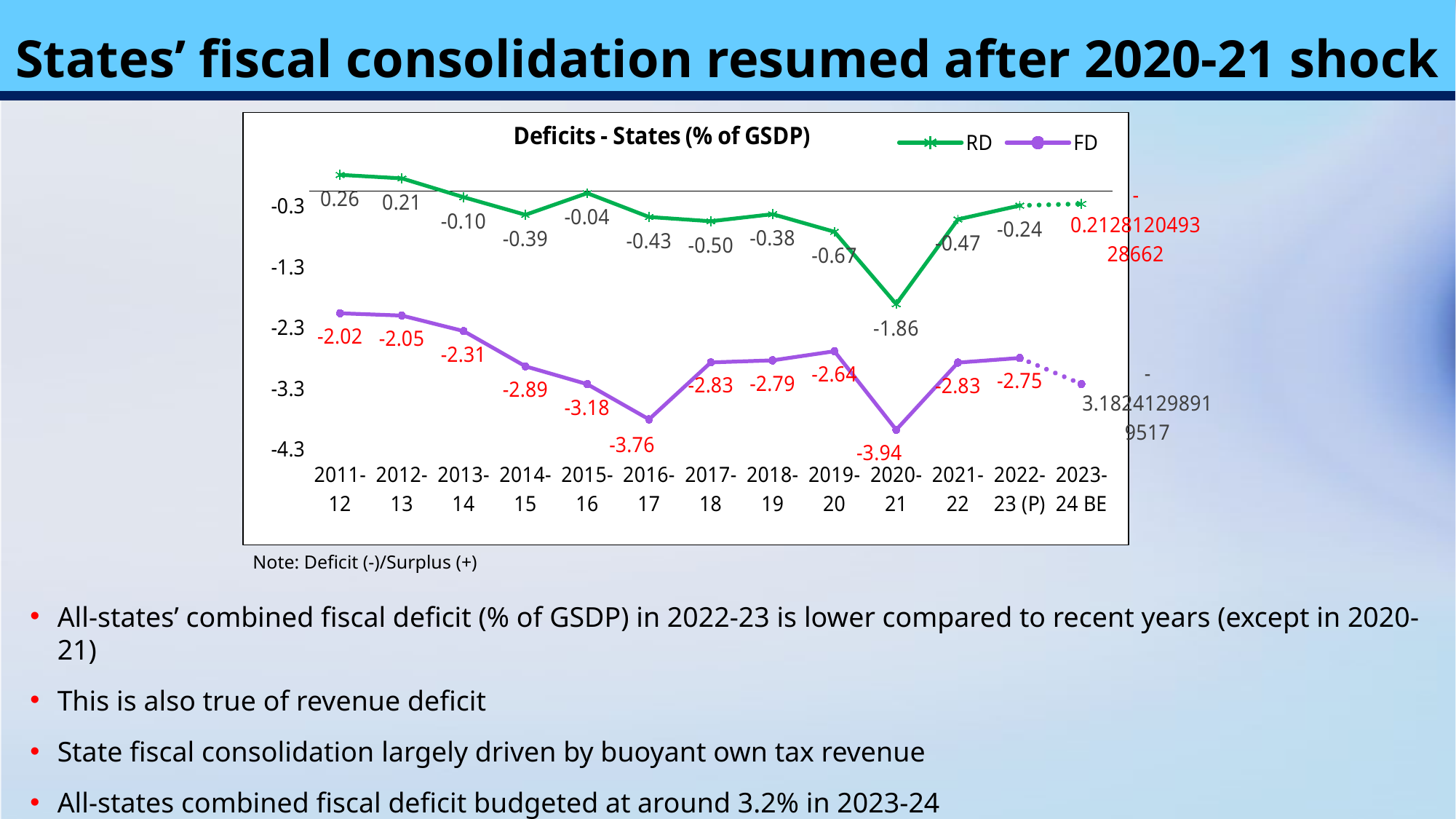
What kind of chart is shown on the slide? line chart How many years are shown on the x axis of the chart? 13 How many series does the legend of the chart list? 2 What is the FD value for 2022-23 (P)? -2.75 Which year has the larger RD value, 2014-15 or 2015-16? 2015-16 Does the FD series rise or fall from 2011-12 to 2016-17? fall What is the RD value for 2020-21? -1.86 In which year is the RD series at its highest value? 2011-12 In which year is the FD series at its lowest value? 2020-21 What is the FD value for 2016-17? -3.76 What is the difference between the FD values for 2015-16 and 2016-17? 0.58 What are the two series names listed in the chart legend? RD and FD